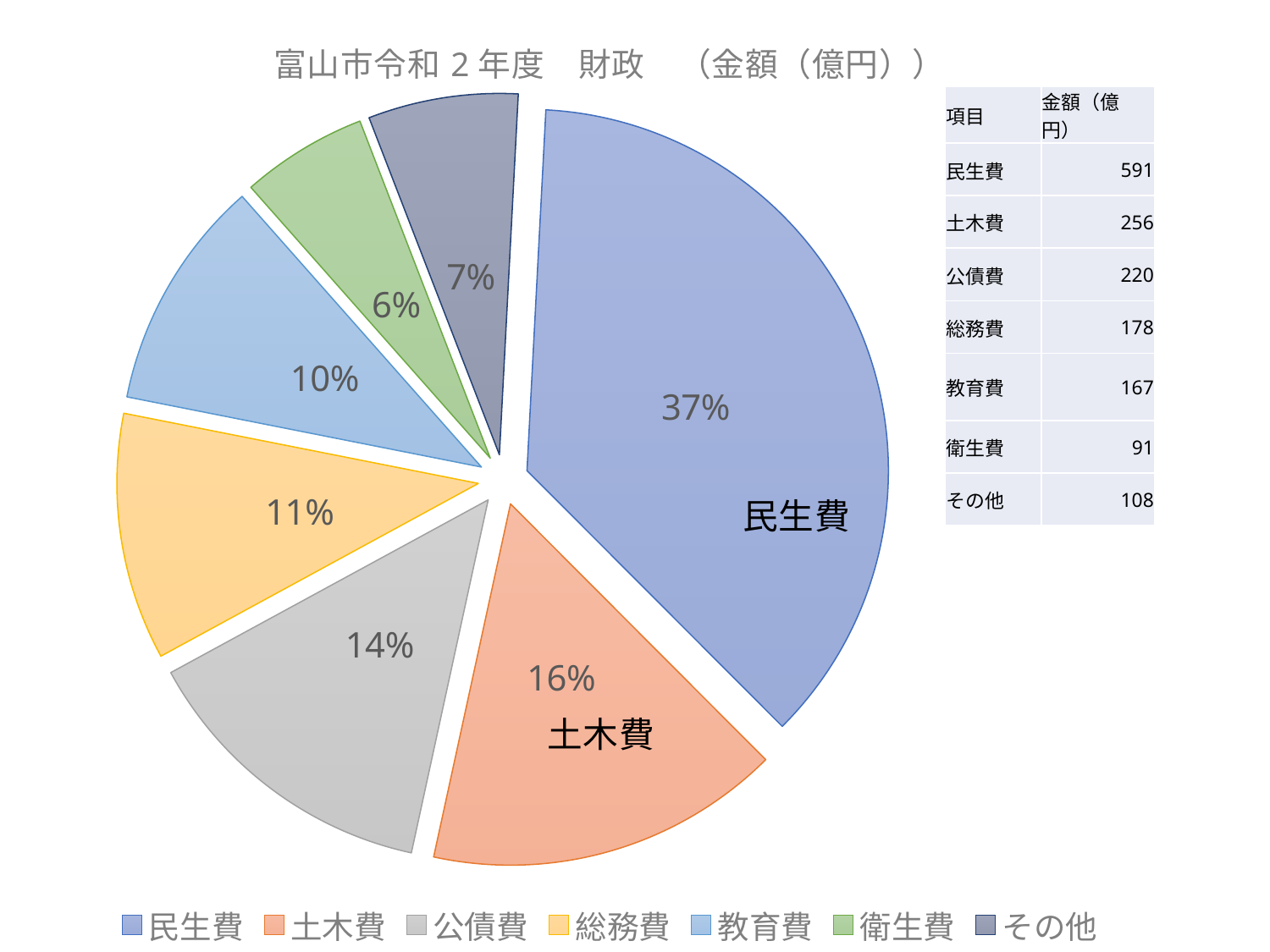
Which is larger, the share for 総務費 or the share for 衛生費? 総務費 What is the difference in percentage points between the 民生費 slice and the 土木費 slice? 21 What is the title of the pie chart? 富山市令和２年度 財政 （金額（億円）） What kind of chart is shown on the slide? pie chart What share of the pie does 土木費 take? 16% How many slices does the pie chart have? 7 Which category has the largest slice of the pie? 民生費 What share of the pie does 公債費 take? 14% Which category has the smallest slice of the pie? 衛生費 What share of the pie does 民生費 take? 37% According to the table on the slide, what is the amount (億円) for 公債費? 220